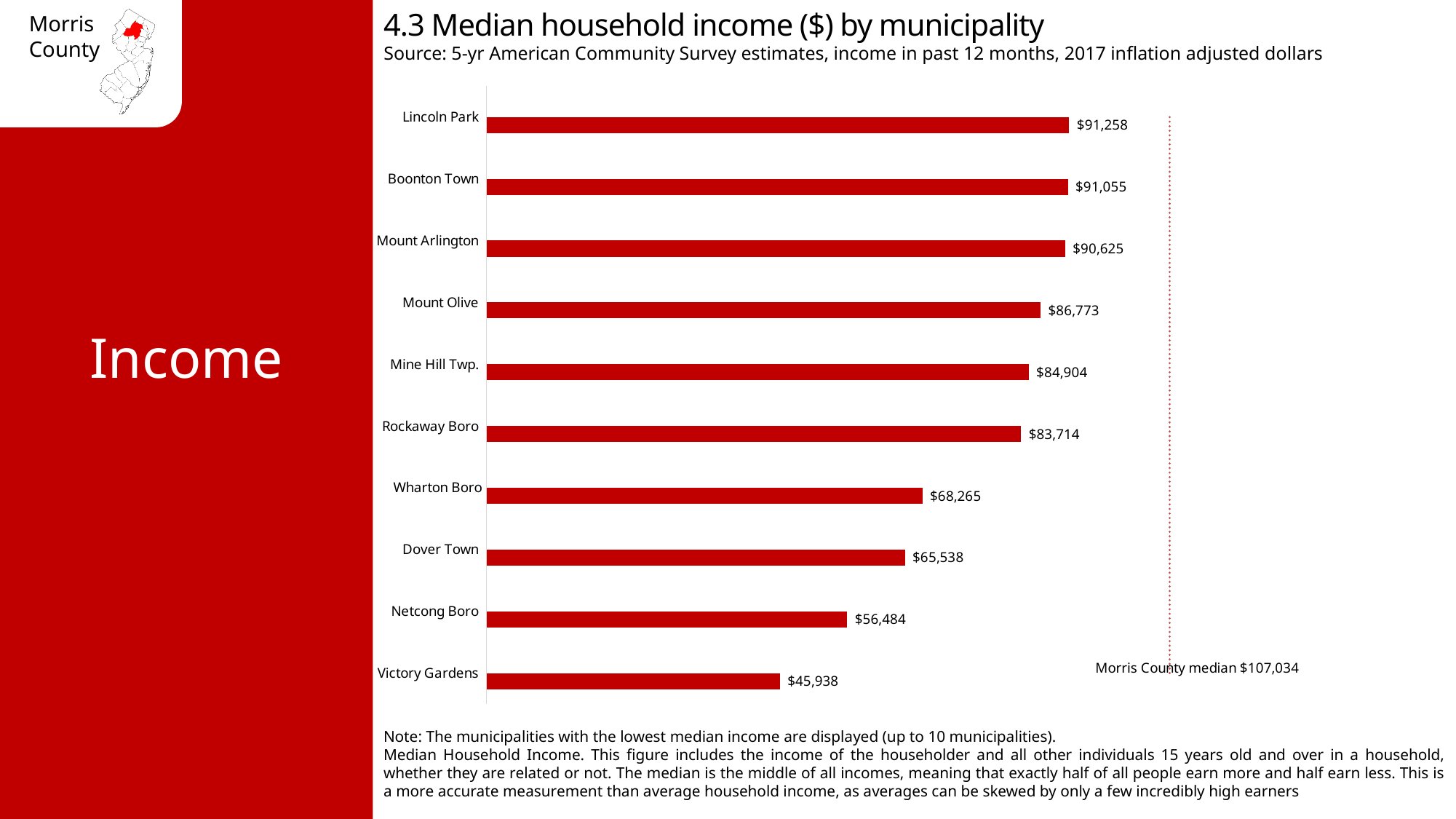
What is the median household income for Mount Olive? $86,773 Which has a higher median household income, Rockaway Boro or Dover Town? Rockaway Boro Which municipality has the highest median household income shown on the chart? Lincoln Park What is the difference between the median household income of Lincoln Park and Victory Gardens? $45,320 What is the difference between the median household income of Wharton Boro and Netcong Boro? $11,781 Which municipality has the lowest median household income shown on the chart? Victory Gardens How many municipalities are shown on the chart? 10 What is the median household income for Dover Town? $65,538 What is the median household income for Victory Gardens? $45,938 What is the Morris County median household income indicated by the dotted line? $107,034 What is the title of the chart? 4.3 Median household income ($) by municipality What kind of chart is shown on the slide? Bar chart